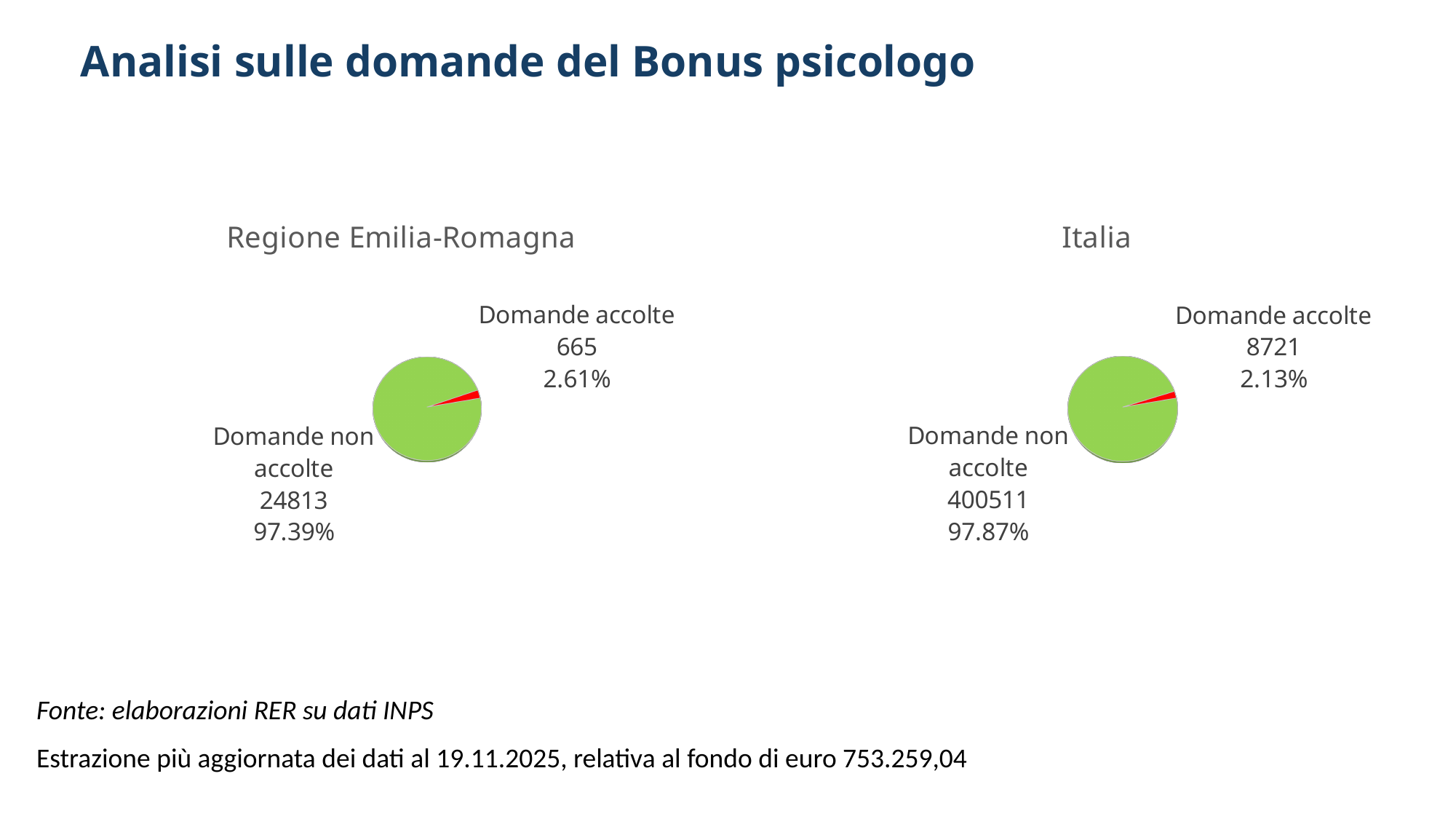
In the 'Italia' chart, which category is the largest? Domande non accolte In the 'Regione Emilia-Romagna' chart, what is the difference between 'Domande non accolte' and 'Domande accolte'? 24148 In the 'Regione Emilia-Romagna' chart, what is the value for 'Domande non accolte'? 24813 What kind of chart is the 'Italia' chart? Pie chart In the 'Italia' chart, what is the value for 'Domande non accolte'? 400511 In the 'Regione Emilia-Romagna' chart, what is the value for 'Domande accolte'? 665 In the 'Regione Emilia-Romagna' chart, which category is the smallest? Domande accolte In the 'Italia' chart, what is the value for 'Domande accolte'? 8721 In the 'Italia' chart, what colour is the 'Domande accolte' slice? Red In the 'Regione Emilia-Romagna' chart, what share of the pie is 'Domande accolte'? 2.61% How many categories does the 'Regione Emilia-Romagna' chart show? 2 In the 'Italia' chart, what share of the pie is 'Domande non accolte'? 97.87%